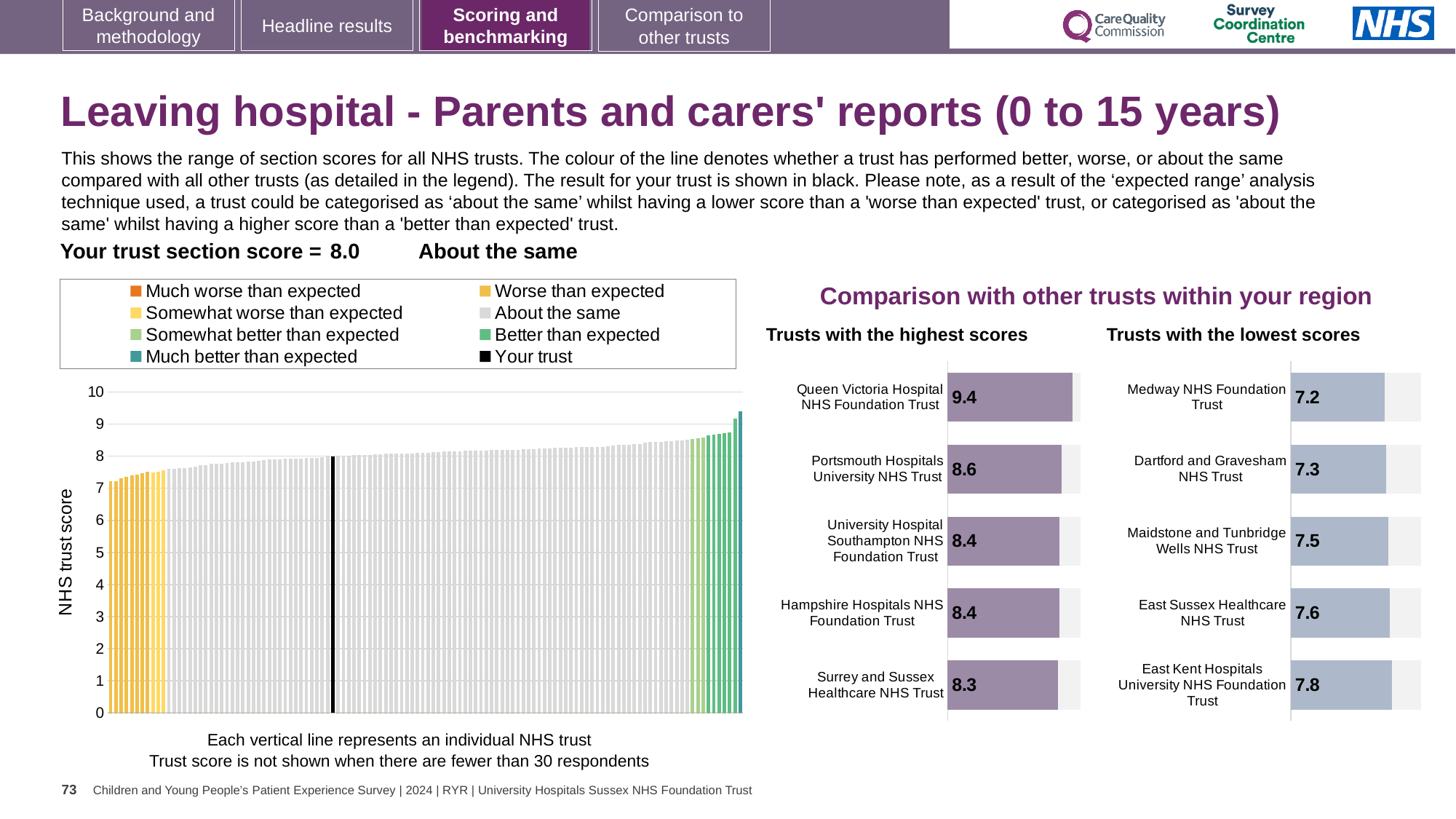
In the 'Trusts with the lowest scores' chart, what is the score for Medway NHS Foundation Trust? 7.2 How many trusts are listed in the 'Trusts with the lowest scores' chart? 5 What kind of chart is the main chart on the left showing NHS trust scores? Bar chart How many entries does the legend of the main 'NHS trust score' chart list? 8 In the 'Trusts with the highest scores' chart, what is the score for Queen Victoria Hospital NHS Foundation Trust? 9.4 In the 'Trusts with the highest scores' chart, what is the difference between Portsmouth Hospitals University NHS Trust and Surrey and Sussex Healthcare NHS Trust? 0.3 What is the difference between the score for Queen Victoria Hospital NHS Foundation Trust in the highest scores chart and the score for Medway NHS Foundation Trust in the lowest scores chart? 2.2 In the 'Trusts with the highest scores' chart, which trust has the highest score? Queen Victoria Hospital NHS Foundation Trust In the 'Trusts with the lowest scores' chart, which trust has the lowest score? Medway NHS Foundation Trust In the 'Trusts with the lowest scores' chart, which has the larger score: Dartford and Gravesham NHS Trust or East Kent Hospitals University NHS Foundation Trust? East Kent Hospitals University NHS Foundation Trust In the main 'NHS trust score' chart, do the bar values rise or fall from left to right? Rise What is the section score for your trust shown in black on the main chart? 8.0